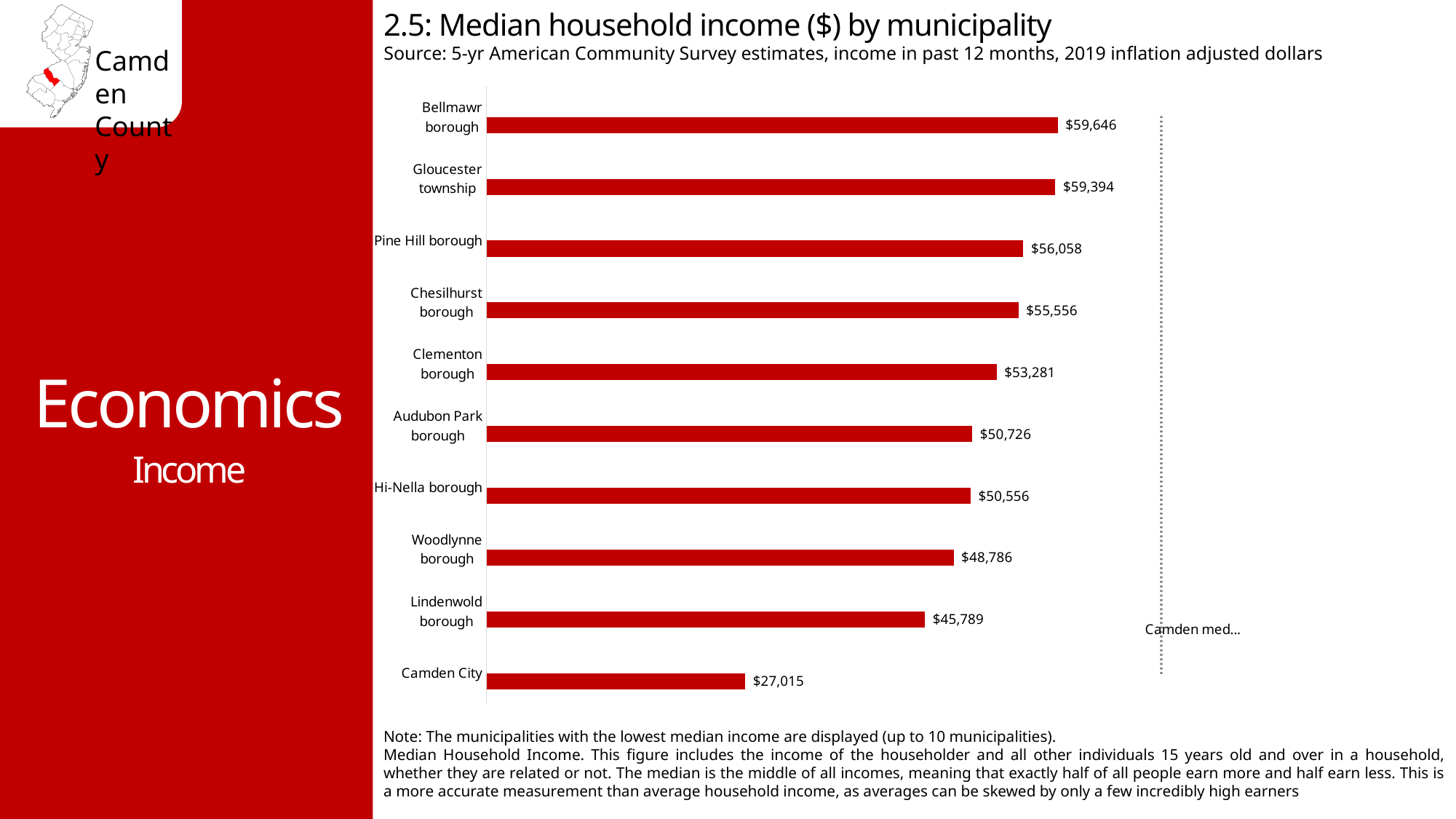
Which municipality has the highest median household income shown on the chart? Bellmawr borough What is the median household income for Camden City? $27,015 Which municipality has the lowest median household income shown on the chart? Camden City What kind of chart is used on this slide? Bar chart What is the median household income for Bellmawr borough? $59,646 What is the difference between the median household income of Bellmawr borough and Camden City? $32,631 What is the title of the chart on this slide? 2.5: Median household income ($) by municipality How many municipalities are shown on the chart? 10 Which has a higher median household income, Clementon borough or Audubon Park borough? Clementon borough What is the difference between the median household income of Pine Hill borough and Chesilhurst borough? $502 What is the median household income for Hi-Nella borough? $50,556 What is the median household income for Lindenwold borough? $45,789